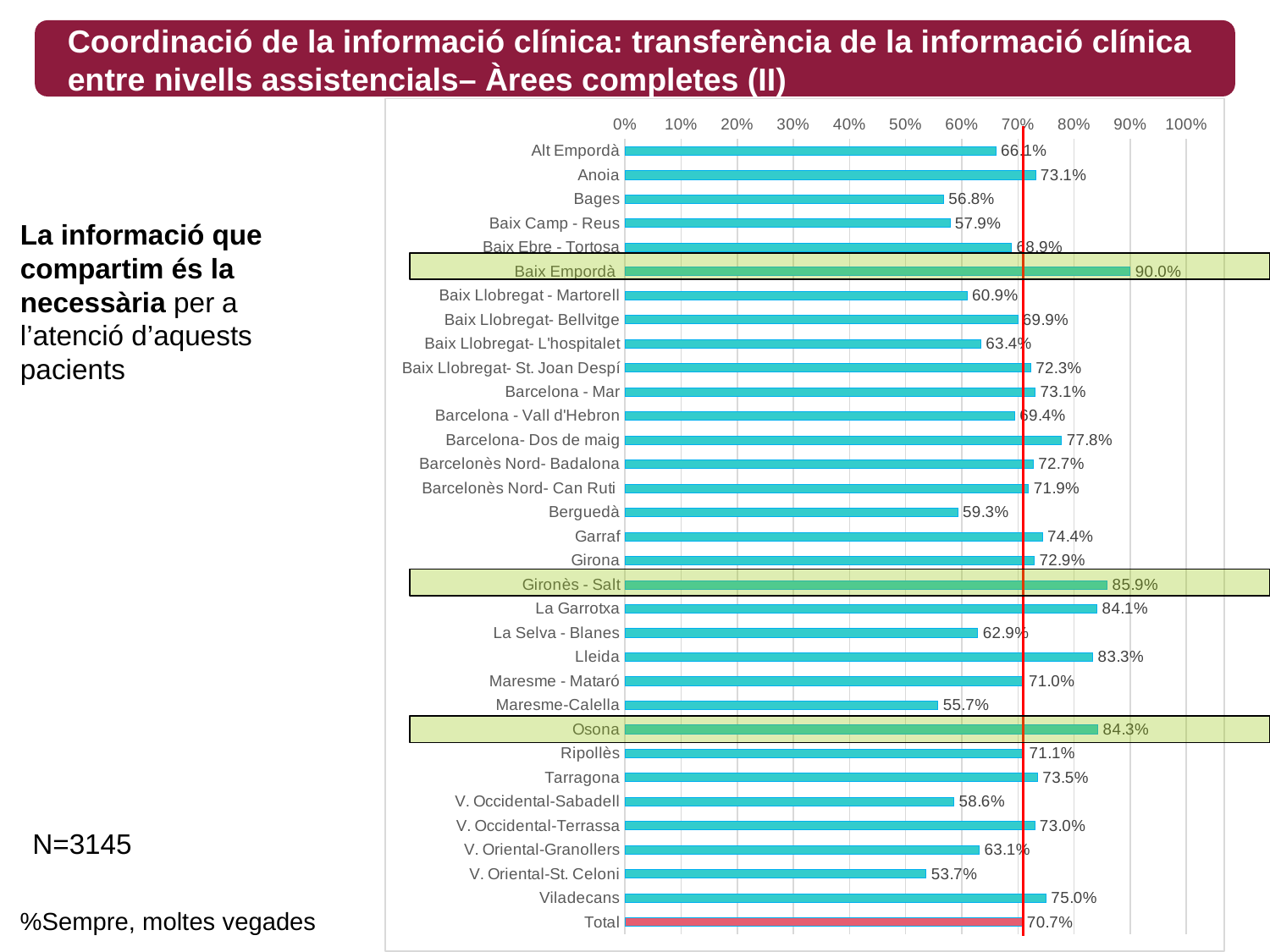
What kind of chart is shown on the slide? bar chart Which is larger, the value for Garraf or the value for Tarragona? Garraf Is the value for Berguedà greater or less than 60%? less What is the difference between the values for Osona and Lleida? 1.0% What is the value for Gironès - Salt? 85.9% What is the value for Baix Empordà? 90.0% What is the value for the Total bar? 70.7% How many bars are plotted in the chart, including Total? 33 What is the value for Maresme-Calella? 55.7% What is the difference between the values for Baix Empordà and the Total? 19.3% Which category has the highest value? Baix Empordà Which category has the lowest value? V. Oriental-St. Celoni